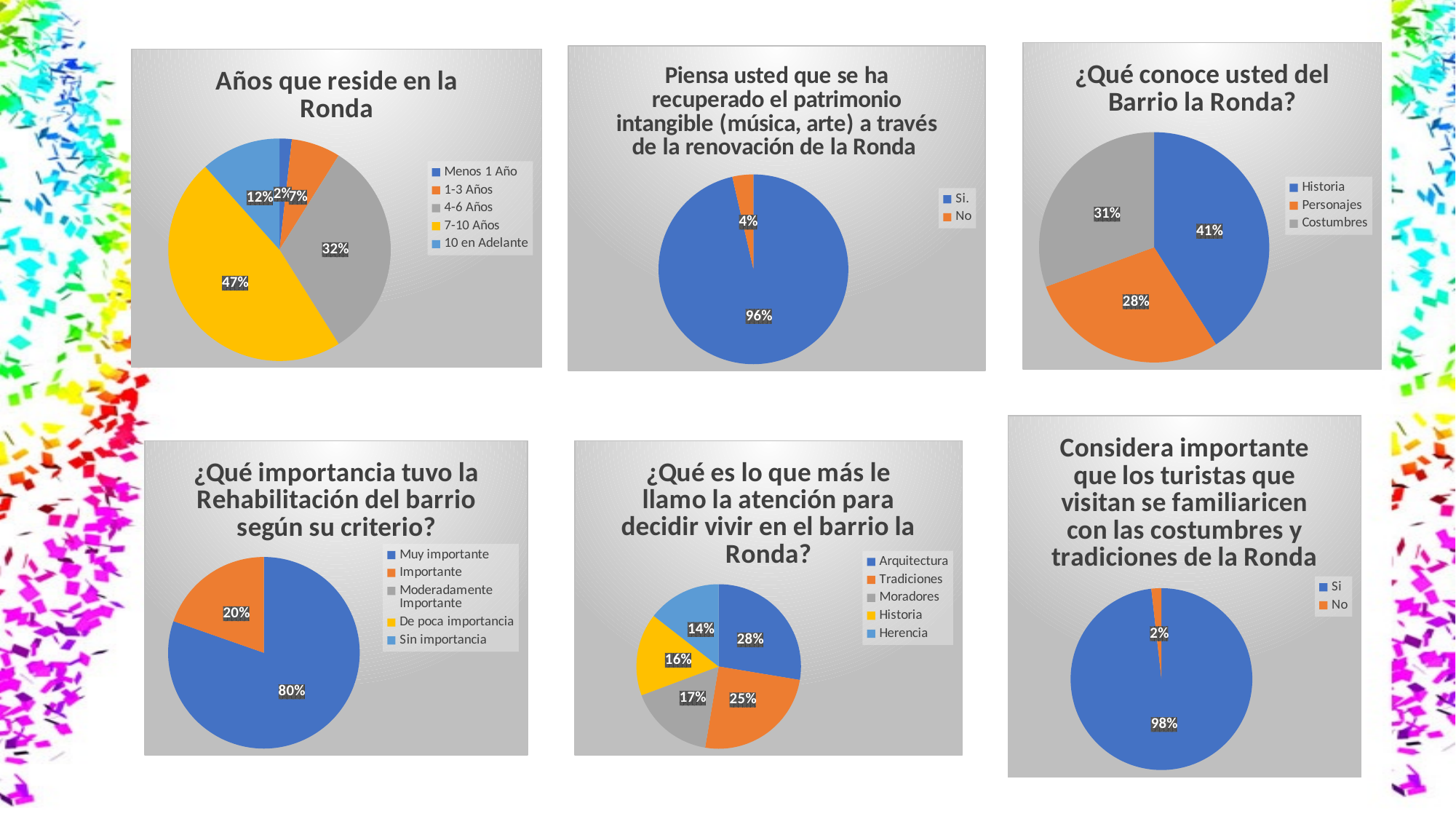
In the 'Años que reside en la Ronda' chart, what share is shown for 7-10 Años? 47% In the 'Años que reside en la Ronda' chart, which category has the smallest slice? Menos 1 Año In the '¿Qué importancia tuvo la Rehabilitación del barrio según su criterio?' chart, what share is shown for Muy importante? 80% In the 'Años que reside en la Ronda' chart, how many categories does the legend list? 5 In the '¿Qué es lo que más le llamo la atención para decidir vivir en el barrio la Ronda?' chart, which is larger, Historia or Herencia? Historia What type of chart is used for 'Considera importante que los turistas que visitan se familiaricen con las costumbres y tradiciones de la Ronda'? Pie chart In the '¿Qué conoce usted del Barrio la Ronda?' chart, which category has the largest slice? Historia In the 'Considera importante que los turistas que visitan se familiaricen con las costumbres y tradiciones de la Ronda' chart, what share answered Si? 98% In the '¿Qué es lo que más le llamo la atención para decidir vivir en el barrio la Ronda?' chart, which category has the largest share? Arquitectura In the chart 'Piensa usted que se ha recuperado el patrimonio intangible (música, arte) a través de la renovación de la Ronda', what share answered No? 4% In the '¿Qué conoce usted del Barrio la Ronda?' chart, what is the difference between the Historia and Personajes shares? 13% In the '¿Qué importancia tuvo la Rehabilitación del barrio según su criterio?' chart, how many entries does the legend list? 5